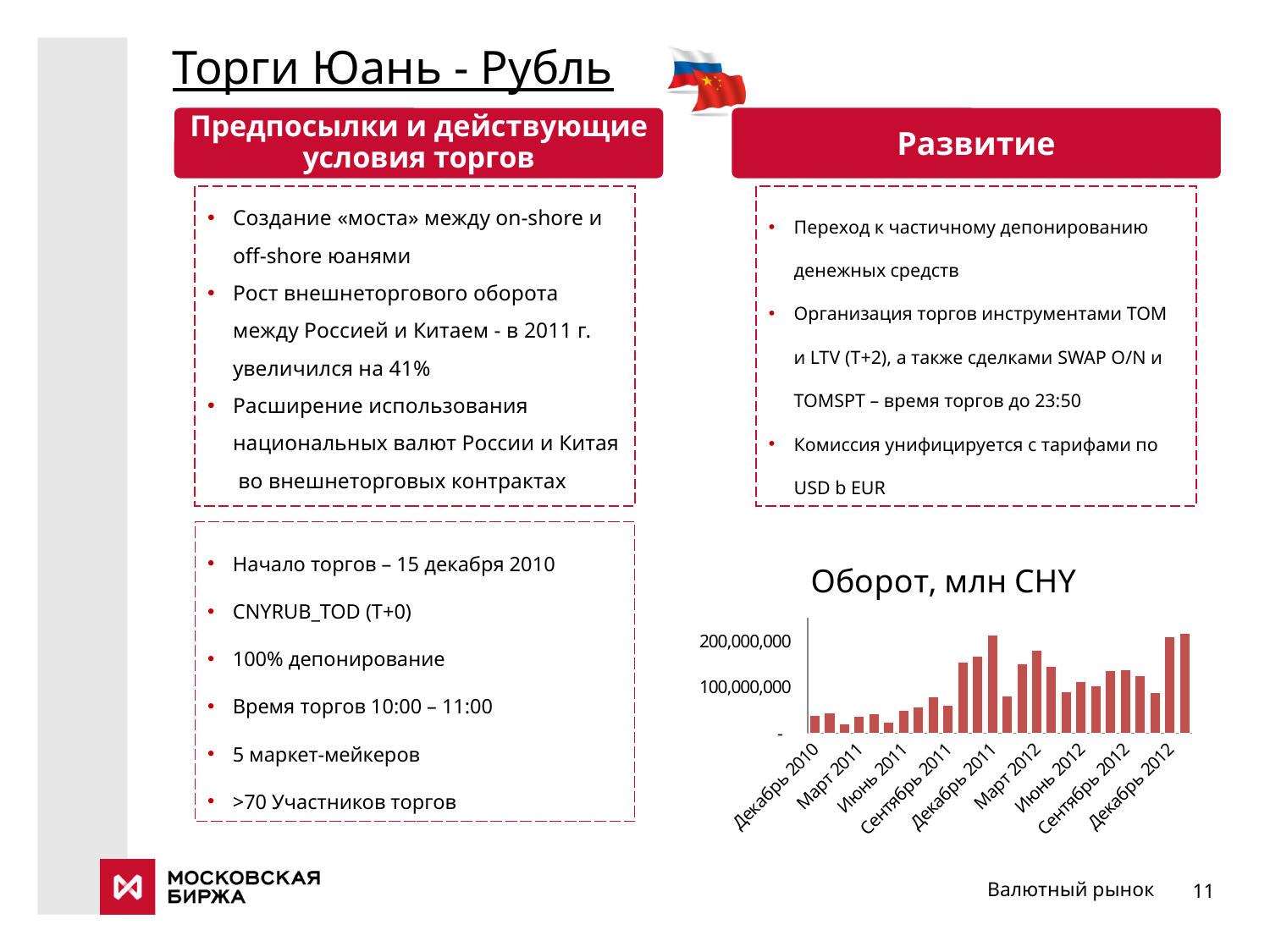
Is the value for Декабрь 2010 greater or less than 100,000,000? less What is the title of the chart on the slide? Оборот, млн CHY Overall, do the values rise or fall from Декабрь 2010 to Декабрь 2012? rise Which is larger, the value for Декабрь 2010 or the value for Декабрь 2011? Декабрь 2011 How many month labels are shown on the x axis of the chart? 9 Is the value for Декабрь 2011 greater or less than 200,000,000? greater Is the value for Март 2012 greater or less than 100,000,000? greater Which is larger, the value for Март 2011 or the value for Март 2012? Март 2012 What kind of chart is shown under the heading "Оборот, млн CHY"? bar chart